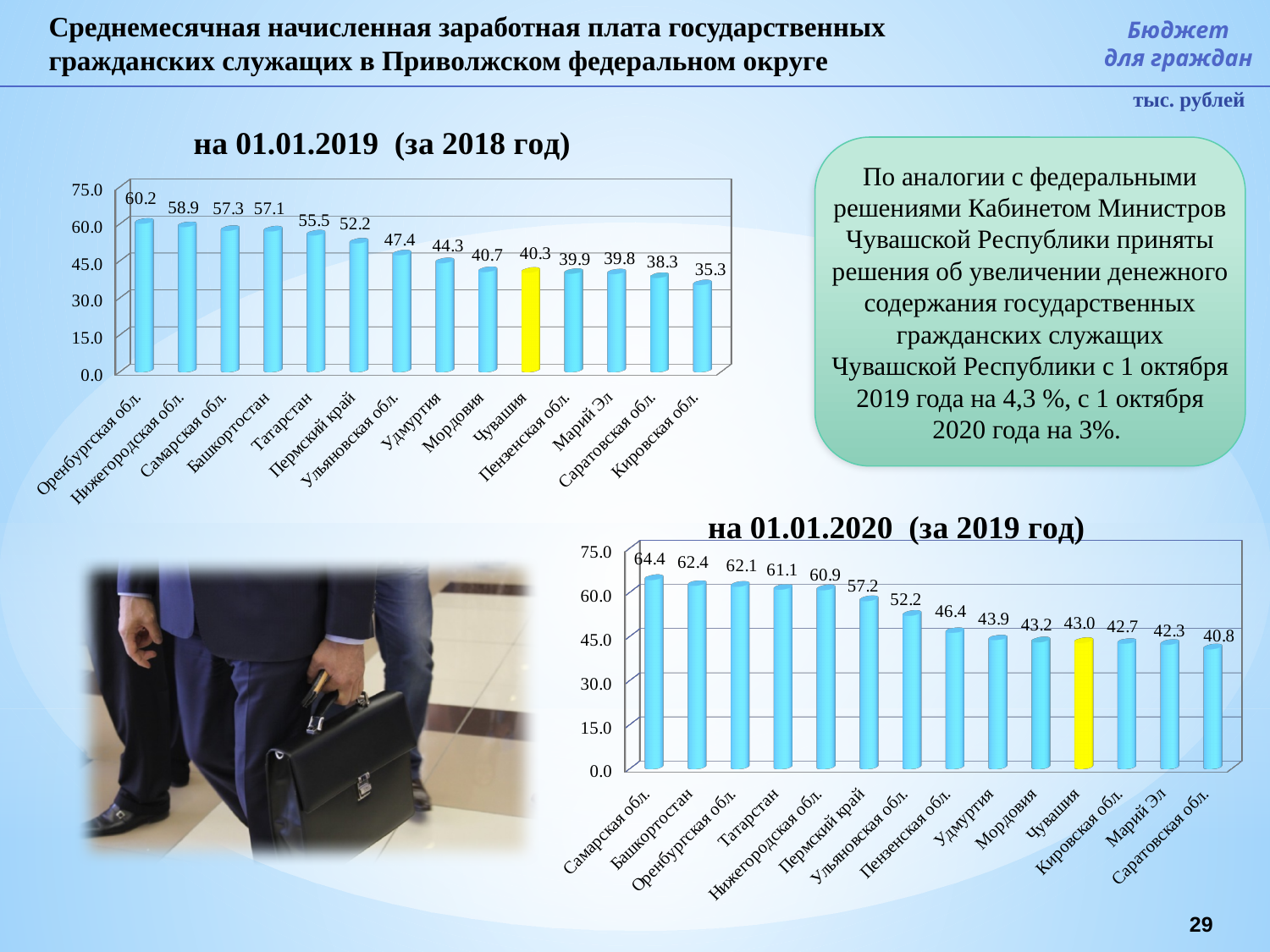
How many regions are shown in the chart 'на 01.01.2020 (за 2019 год)'? 14 In the chart 'на 01.01.2020 (за 2019 год)', which region's bar is highlighted in yellow? Чувашия In the chart 'на 01.01.2020 (за 2019 год)', which region has the lowest value? Саратовская обл. In the chart 'на 01.01.2019 (за 2018 год)', which is larger: the value for Татарстан or the value for Пермский край? Татарстан In the chart 'на 01.01.2020 (за 2019 год)', what is the value for Чувашия? 43.0 In the chart 'на 01.01.2019 (за 2018 год)', which region has the highest value? Оренбургская обл. In the chart 'на 01.01.2020 (за 2019 год)', do the values rise or fall from left to right? fall In the chart 'на 01.01.2019 (за 2018 год)', what is the value for Ульяновская обл.? 47.4 What kind of chart is 'на 01.01.2019 (за 2018 год)'? bar chart In the chart 'на 01.01.2019 (за 2018 год)', what is the value for Чувашия? 40.3 In the chart 'на 01.01.2020 (за 2019 год)', what is the difference between the values for Самарская обл. and Саратовская обл.? 23.6 In the chart 'на 01.01.2019 (за 2018 год)', is the value for Кировская обл. greater or less than 45.0? less